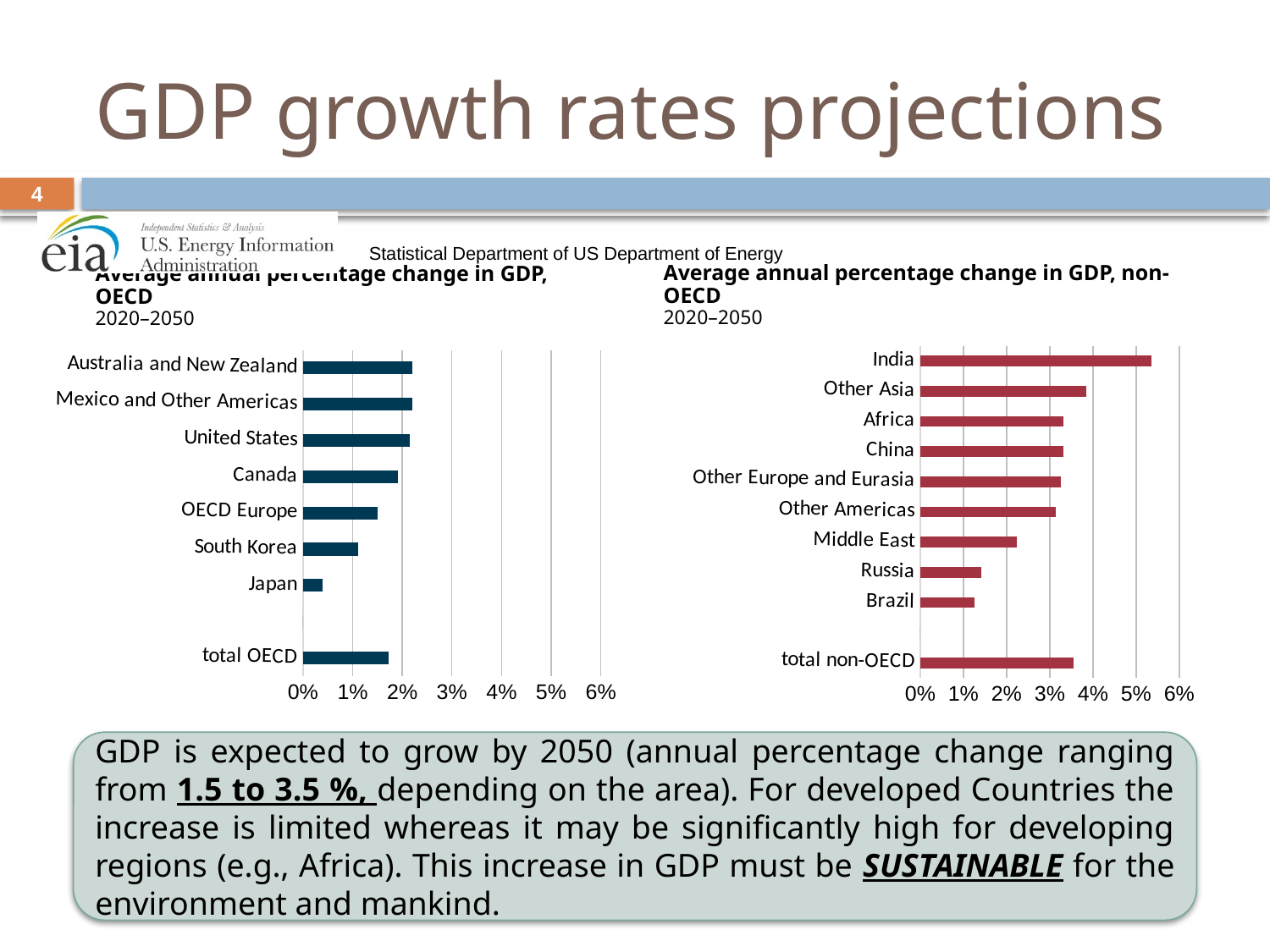
What time period is shown under the titles of both charts? 2020–2050 In the left chart (OECD), is the value for Japan greater or less than 1%? less How many categories are plotted in the left chart (OECD)? 8 How many categories are plotted in the right chart (non-OECD)? 10 In the right chart (non-OECD), which category has the highest value? India In the left chart (OECD), is the value for Canada greater or less than 1%? greater In the left chart (OECD), which is larger, the value for South Korea or the value for OECD Europe? OECD Europe In the right chart (non-OECD), which category has the lowest value? Brazil In the right chart (non-OECD), is the value for India greater or less than 5%? greater What kind of chart is the 'Average annual percentage change in GDP, OECD' chart on the left? bar chart In the right chart (non-OECD), which is larger, the value for Middle East or the value for Russia? Middle East In the left chart (OECD), which category has the lowest value? Japan